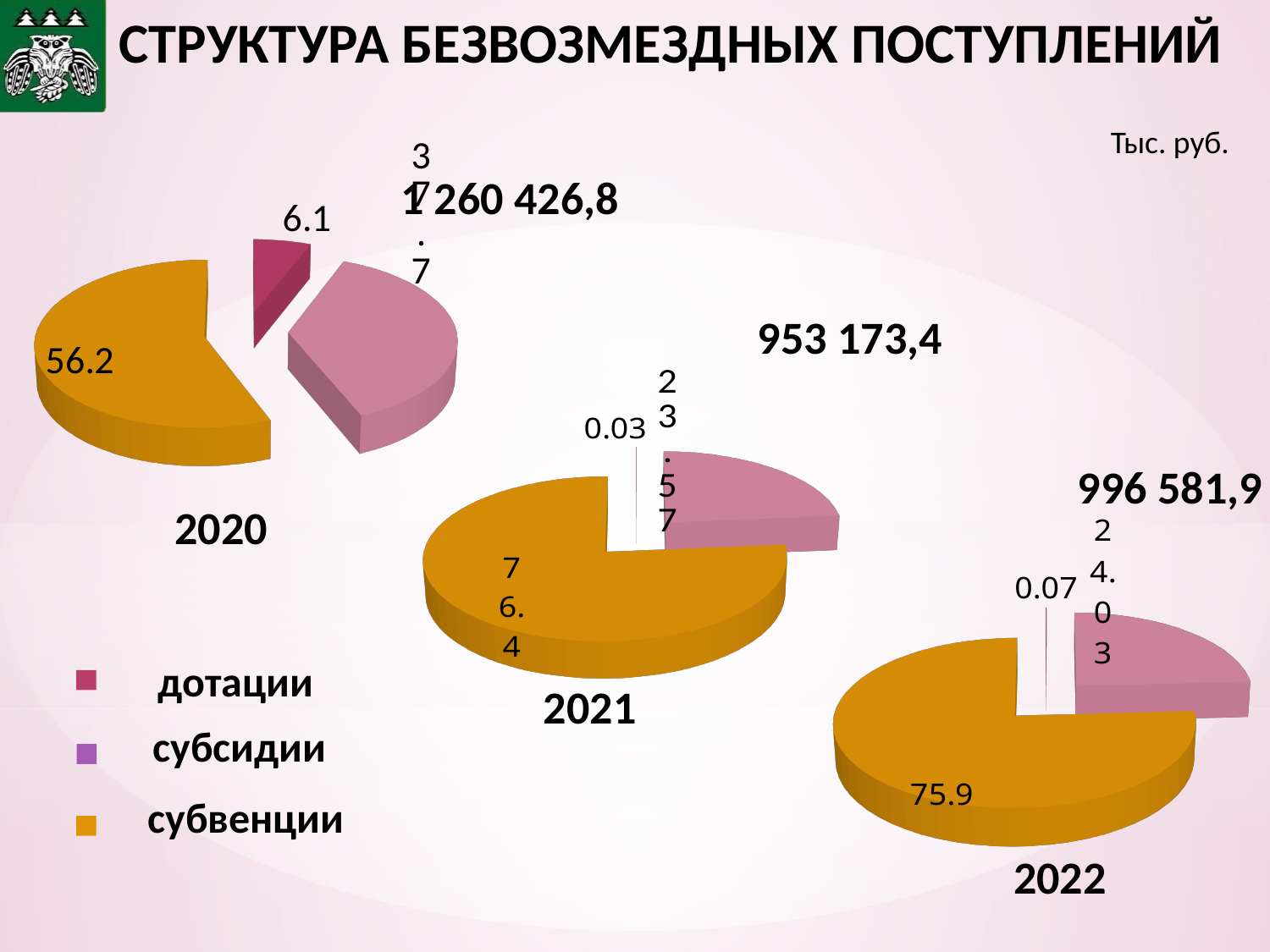
In the 2021 pie chart, which category has the smallest slice? дотации In the 2022 pie chart, what is the value shown for дотации? 0.07 Which is larger: the субвенции value in the 2021 chart or in the 2022 chart? 2021 In the 2020 pie chart, what is the value shown for субвенции? 56.2 What kind of charts are shown on the slide? pie charts In the 2021 pie chart, what is the value shown for субвенции? 76.4 In the 2022 pie chart, what is the value shown for субсидии? 24.03 What is the difference between the субвенции value in the 2022 chart and in the 2020 chart? 19.7 In the 2021 pie chart, what is the value shown for дотации? 0.03 How many categories does the legend list? 3 In the 2022 pie chart, which category has the largest slice? субвенции In the 2020 pie chart, what is the value shown for дотации? 6.1